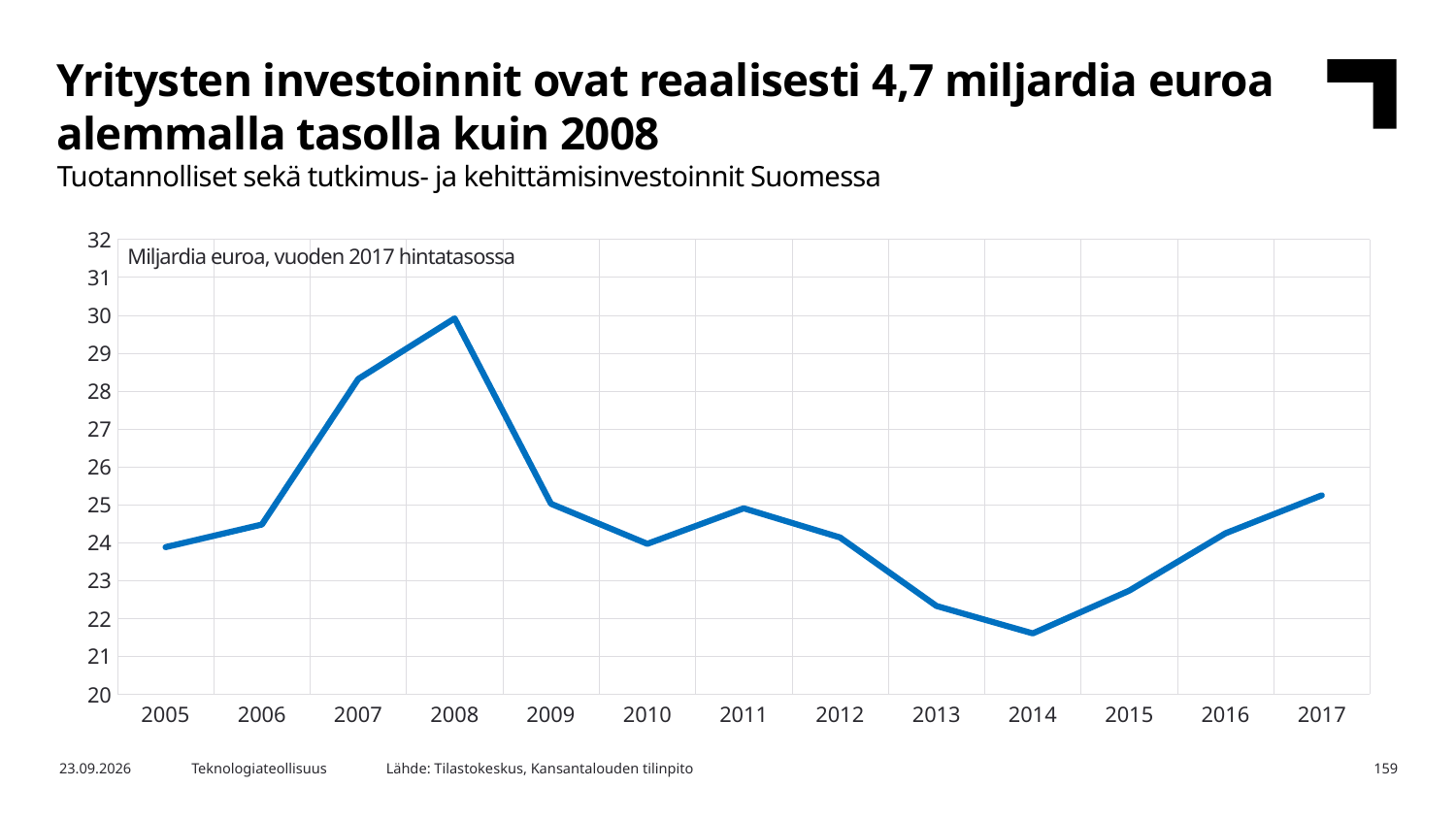
Is the value for 2013 greater or less than 23? less How many years are plotted on the x axis? 13 Is the value for 2008 greater or less than 29? greater Is the value for 2007 greater or less than 27? greater What kind of chart is shown on the slide? Line chart What unit is stated in the label inside the chart area? Miljardia euroa, vuoden 2017 hintatasossa Do the values rise or fall from 2008 to 2014? fall Which is larger, the value for 2007 or the value for 2009? 2007 Which year has the lowest value on the chart? 2014 Which year has the highest value on the chart? 2008